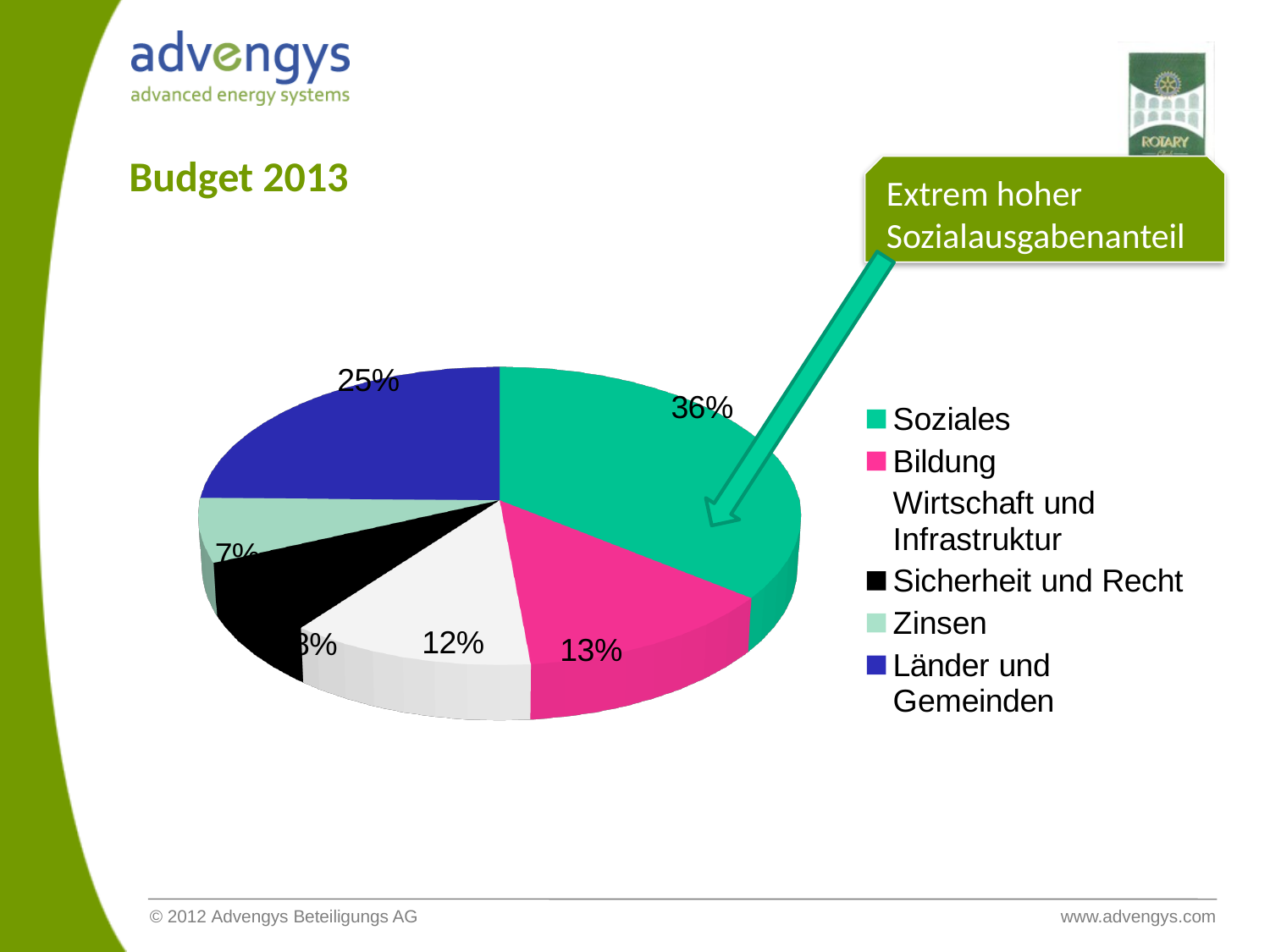
Which category has the largest share of the budget? Soziales What percentage of the budget goes to Soziales? 36% What is the difference in percentage points between the Soziales share and the Länder und Gemeinden share? 11 What percentage of the budget goes to Länder und Gemeinden? 25% What percentage of the budget goes to Bildung? 13% Which is larger, the share for Bildung or the share for Länder und Gemeinden? Länder und Gemeinden What is the difference in percentage points between the Bildung share and the Wirtschaft und Infrastruktur share? 1 How many categories does the legend list? 6 What kind of chart is shown on the slide? pie chart What percentage of the budget goes to Wirtschaft und Infrastruktur? 12% What is the title of the chart? Budget 2013 Which colour represents Sicherheit und Recht in the pie chart? black